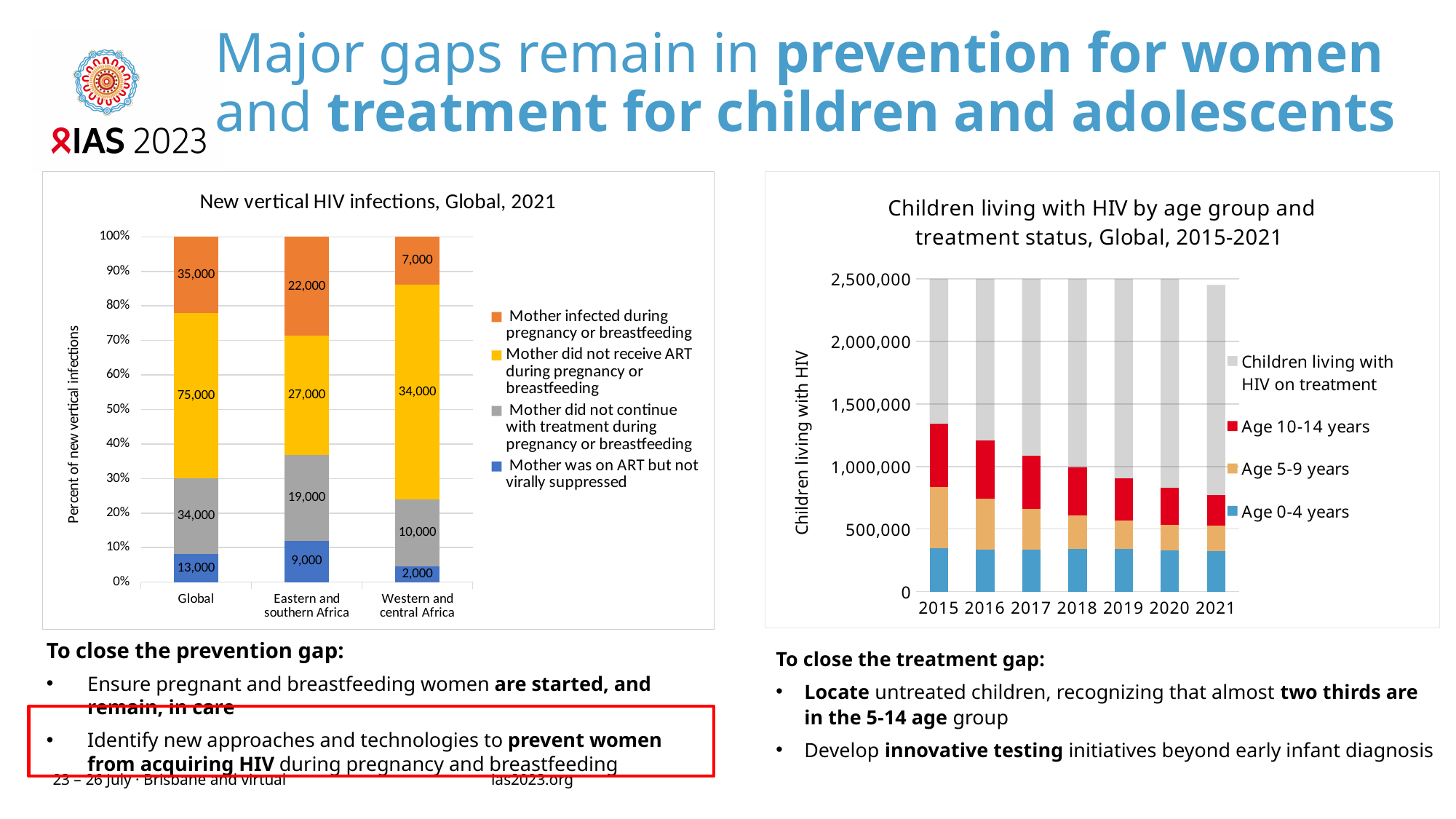
In the chart 'Children living with HIV by age group and treatment status, Global, 2015-2021', is the value for 'Age 0-4 years' in 2015 greater or less than 500,000? less In the chart 'Children living with HIV by age group and treatment status, Global, 2015-2021', does the 'Age 10-14 years' segment rise or fall from 2015 to 2021? fall How many series does the legend of the chart 'New vertical HIV infections, Global, 2021' list? 4 How many years are shown on the x axis of the chart 'Children living with HIV by age group and treatment status, Global, 2015-2021'? 7 In the chart 'New vertical HIV infections, Global, 2021', what is the value for 'Mother did not receive ART during pregnancy or breastfeeding' in the Global bar? 75,000 In the chart 'New vertical HIV infections, Global, 2021', which category in the Global bar has the lowest value? Mother was on ART but not virally suppressed In the chart 'New vertical HIV infections, Global, 2021', what is the value for 'Mother was on ART but not virally suppressed' in Western and central Africa? 2,000 In the chart 'New vertical HIV infections, Global, 2021', which region has the larger value for 'Mother did not continue with treatment during pregnancy or breastfeeding': Eastern and southern Africa or Western and central Africa? Eastern and southern Africa What kind of chart is 'Children living with HIV by age group and treatment status, Global, 2015-2021'? Stacked bar chart In the chart 'New vertical HIV infections, Global, 2021', what is the value for 'Mother infected during pregnancy or breastfeeding' in Eastern and southern Africa? 22,000 In the chart 'New vertical HIV infections, Global, 2021', what is the total of the Eastern and southern Africa bar? 77,000 In the chart 'New vertical HIV infections, Global, 2021', what is the difference between 'Mother did not receive ART during pregnancy or breastfeeding' in Eastern and southern Africa and in Western and central Africa? 7,000